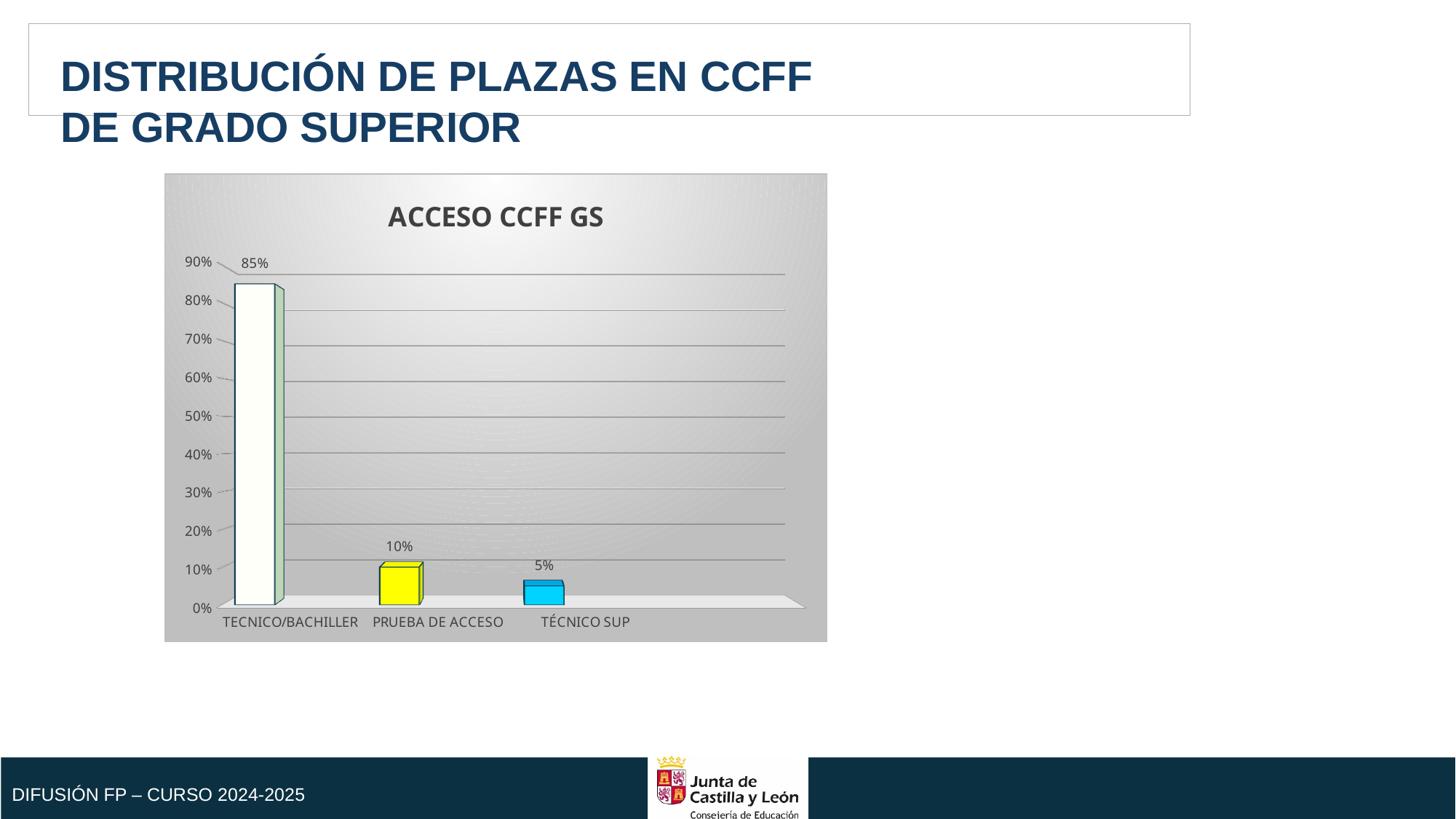
What is the value for TÉCNICO SUP? 5% What is the value for TECNICO/BACHILLER? 85% Which is larger, the value for PRUEBA DE ACCESO or the value for TÉCNICO SUP? PRUEBA DE ACCESO What is the value for PRUEBA DE ACCESO? 10% Which category has the highest value? TECNICO/BACHILLER How many categories are shown on the x axis? 3 What is the difference between the values for PRUEBA DE ACCESO and TÉCNICO SUP? 5% What is the title of the chart? ACCESO CCFF GS Is the value for TECNICO/BACHILLER greater or less than 80%? greater What is the difference between the values for TECNICO/BACHILLER and PRUEBA DE ACCESO? 75% What kind of chart is shown on the slide? bar chart Which category has the lowest value? TÉCNICO SUP